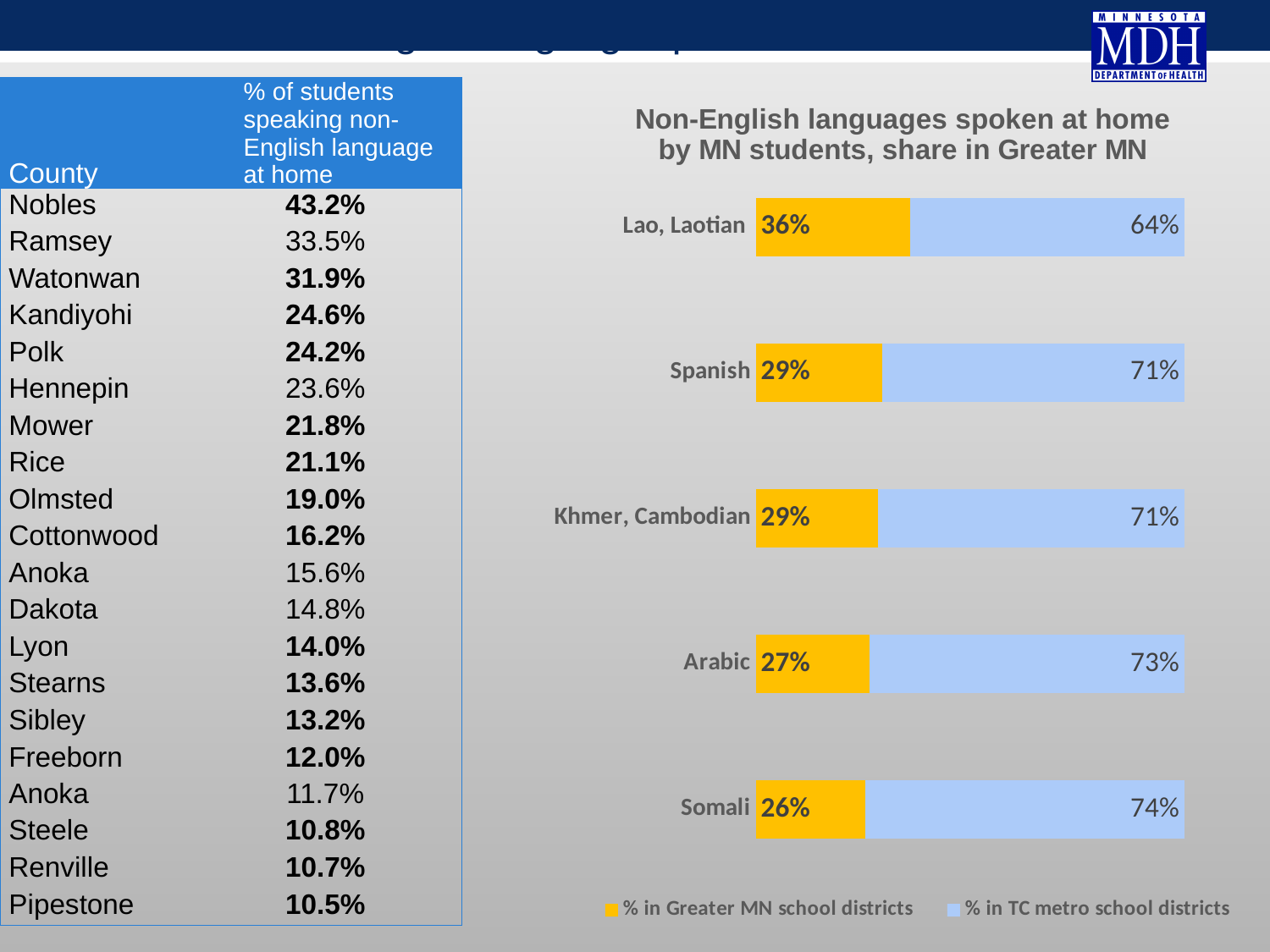
Which language has the lowest % in Greater MN school districts? Somali How many languages are shown in the chart? 5 What is the % in Greater MN school districts for Lao, Laotian? 36% What is the difference between the % in Greater MN school districts for Lao, Laotian and for Somali? 10% How many series does the chart legend list? 2 What is the title of the chart? Non-English languages spoken at home by MN students, share in Greater MN Which language has the highest % in Greater MN school districts? Lao, Laotian What is the % in Greater MN school districts for Arabic? 27% What type of chart is shown on the slide? Stacked bar chart What is the total of the two segments in the Spanish bar? 100% Which is larger: the % in TC metro school districts for Arabic or for Spanish? Arabic What is the % in TC metro school districts for Somali? 74%